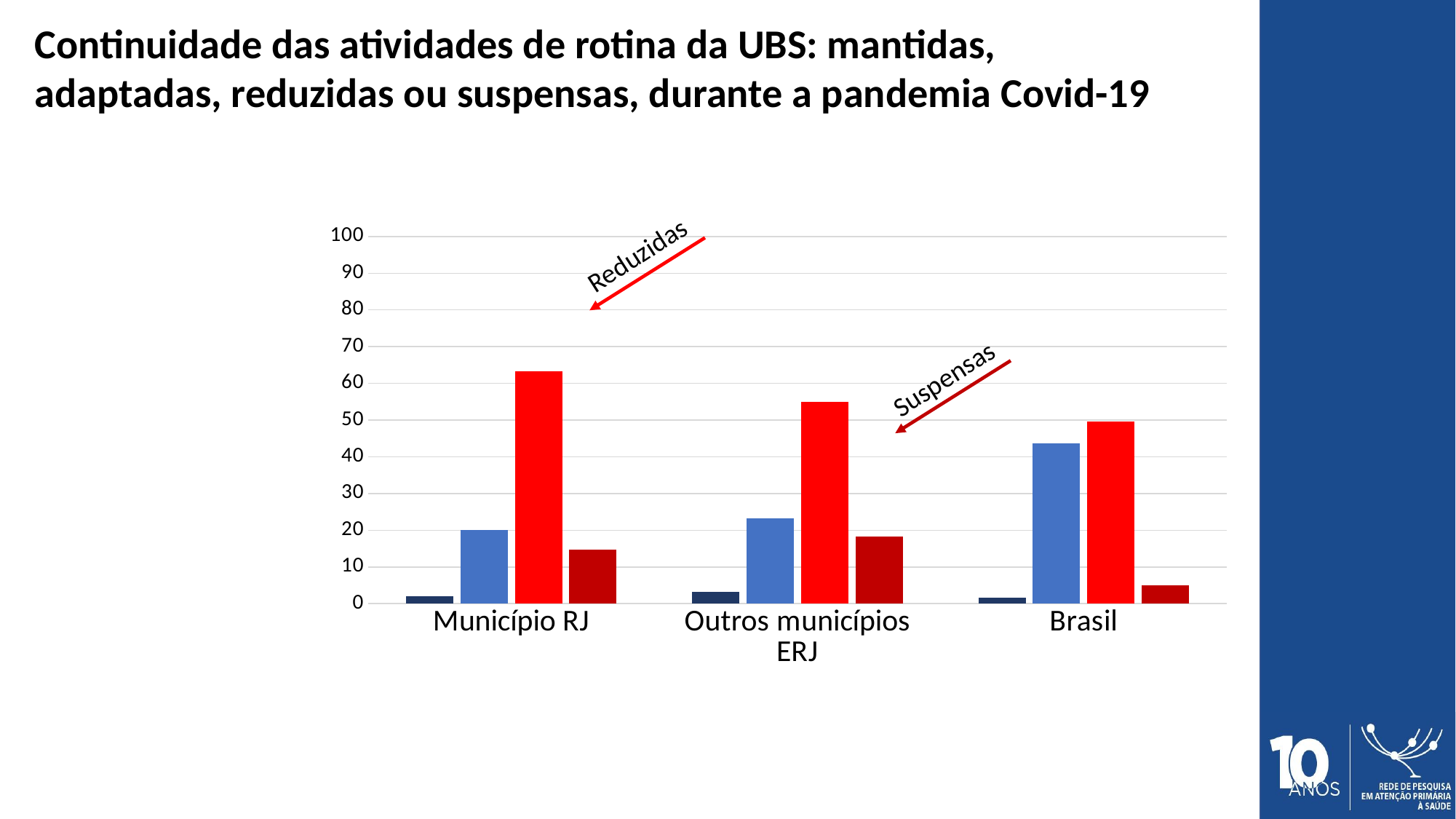
Is the value of the Reduzidas bar for Município RJ greater or less than 60? greater Is the value of the Suspensas bar for Outros municípios ERJ greater or less than 10? greater Which is larger, the Reduzidas bar for Município RJ or for Outros municípios ERJ? Município RJ Which category has the highest Reduzidas bar? Município RJ Which category has the lowest Suspensas bar? Brasil Which is larger, the Suspensas bar for Município RJ or for Brasil? Município RJ Is the value of the Suspensas bar for Brasil greater or less than 10? less How many categories are shown on the x axis of the chart? 3 How many bars are plotted for each category in the chart? 4 What kind of chart is shown on the slide? bar chart Do the Reduzidas bars rise or fall from left to right across the categories? fall